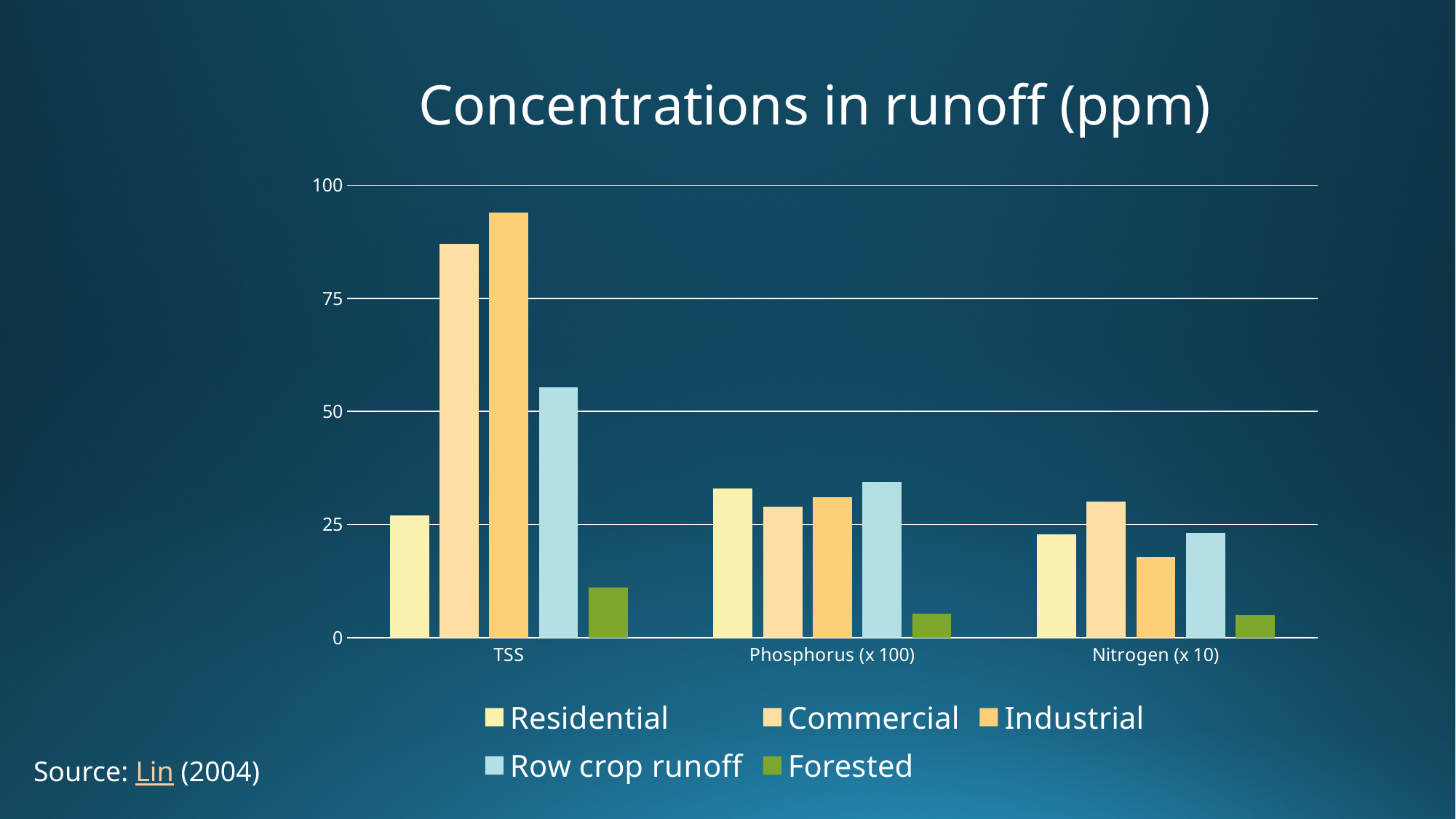
Which series has the lowest value for TSS? Forested How many series does the legend list? 5 Is the Commercial value for TSS greater or less than 75? greater Is the Industrial value for Nitrogen (x 10) greater or less than 25? less Which series is shown in green in the legend? Forested Which series has the lowest value for Phosphorus (x 100)? Forested Which series has the highest value for Nitrogen (x 10)? Commercial What kind of chart is shown on the slide? bar chart What is the title of the chart? Concentrations in runoff (ppm) For TSS, which is larger: the Commercial value or the Row crop runoff value? Commercial Which series has the highest value for TSS? Industrial How many categories are shown on the x axis? 3